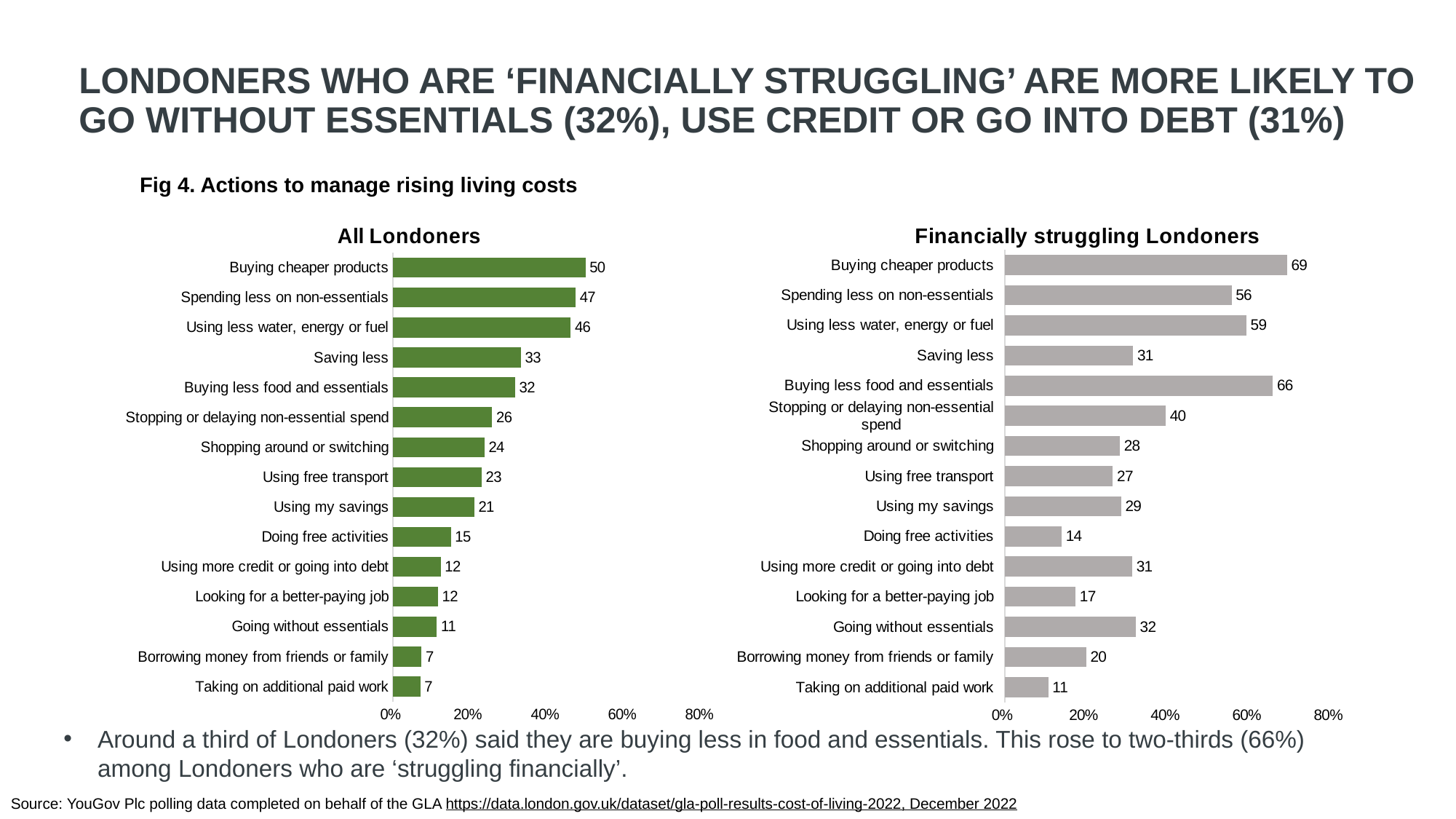
How many categories are shown in the 'All Londoners' chart? 15 In the 'Financially struggling Londoners' chart, what is the value for 'Buying less food and essentials'? 66 What kind of chart is the 'Financially struggling Londoners' chart? Bar chart In the 'Financially struggling Londoners' chart, which category has the lowest value? Taking on additional paid work In the 'All Londoners' chart, is the value for 'Saving less' greater or less than 40%? less What is the difference between the 'Buying less food and essentials' value in the 'Financially struggling Londoners' chart and the same category in the 'All Londoners' chart? 34 In the 'All Londoners' chart, which category has the lowest value? Borrowing money from friends or family and Taking on additional paid work (both 7) What is the figure caption above the two charts? Fig 4. Actions to manage rising living costs In the 'All Londoners' chart, what is the value for 'Buying cheaper products'? 50 In the 'All Londoners' chart, what is the value for 'Using more credit or going into debt'? 12 In the 'Financially struggling Londoners' chart, which category has the highest value? Buying cheaper products In the 'Financially struggling Londoners' chart, which is larger: 'Spending less on non-essentials' or 'Using less water, energy or fuel'? Using less water, energy or fuel